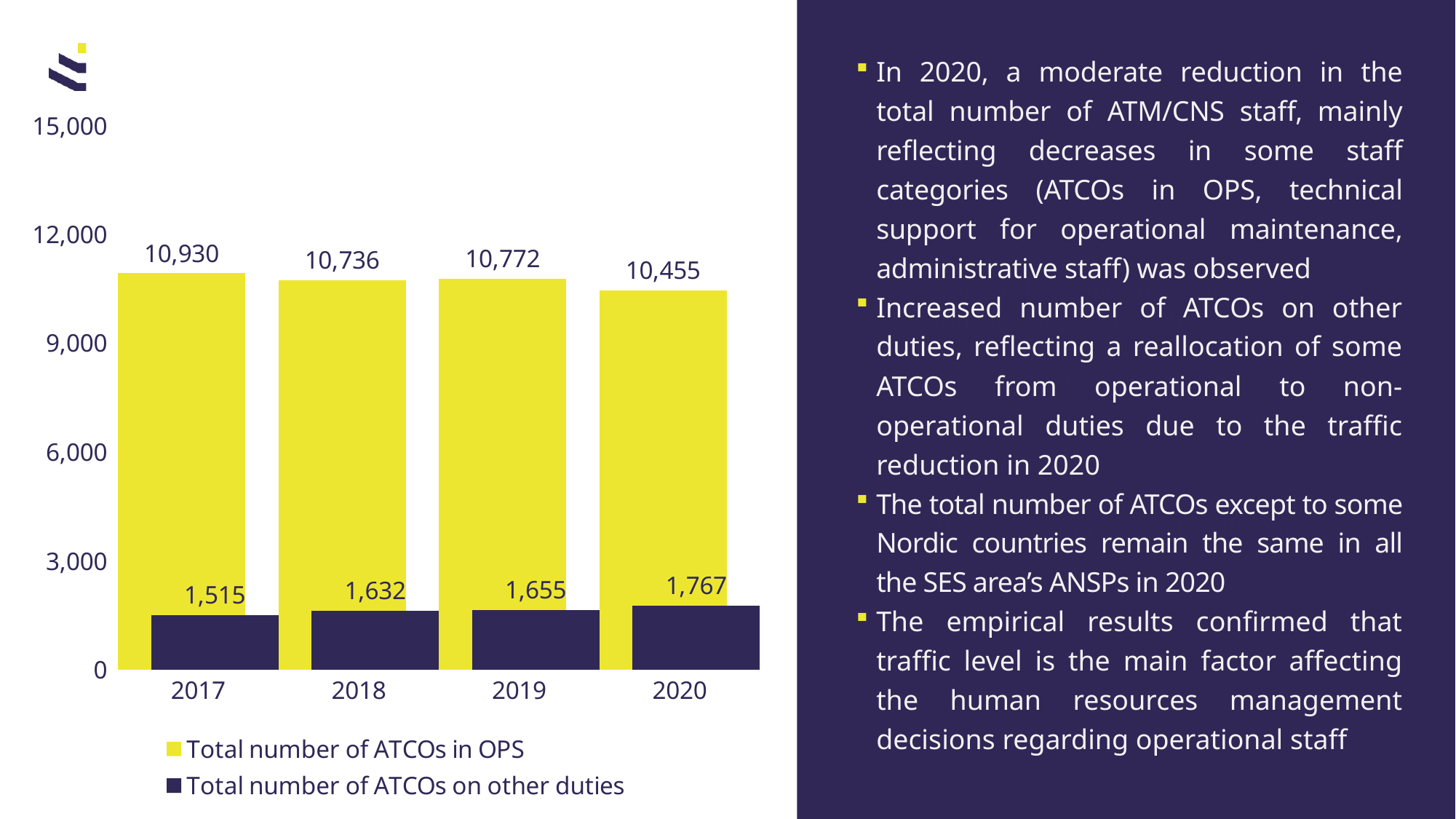
What is the total number of ATCOs on other duties in 2020? 1,767 What is the difference between the total number of ATCOs in OPS in 2017 and in 2020? 475 Which is larger: the total number of ATCOs on other duties in 2018 or in 2019? 2019 How many series does the chart legend list? 2 How many years are shown on the x axis of the chart? 4 Do the values for total number of ATCOs on other duties rise or fall from 2017 to 2020? rise What kind of chart is shown on the slide? bar chart Is the value for ATCOs in OPS in 2020 greater or less than 9,000? greater Which year has the lowest total number of ATCOs on other duties? 2017 Which year has the highest total number of ATCOs in OPS? 2017 What is the total number of ATCOs in OPS in 2017? 10,930 What is the total number of ATCOs in OPS in 2019? 10,772